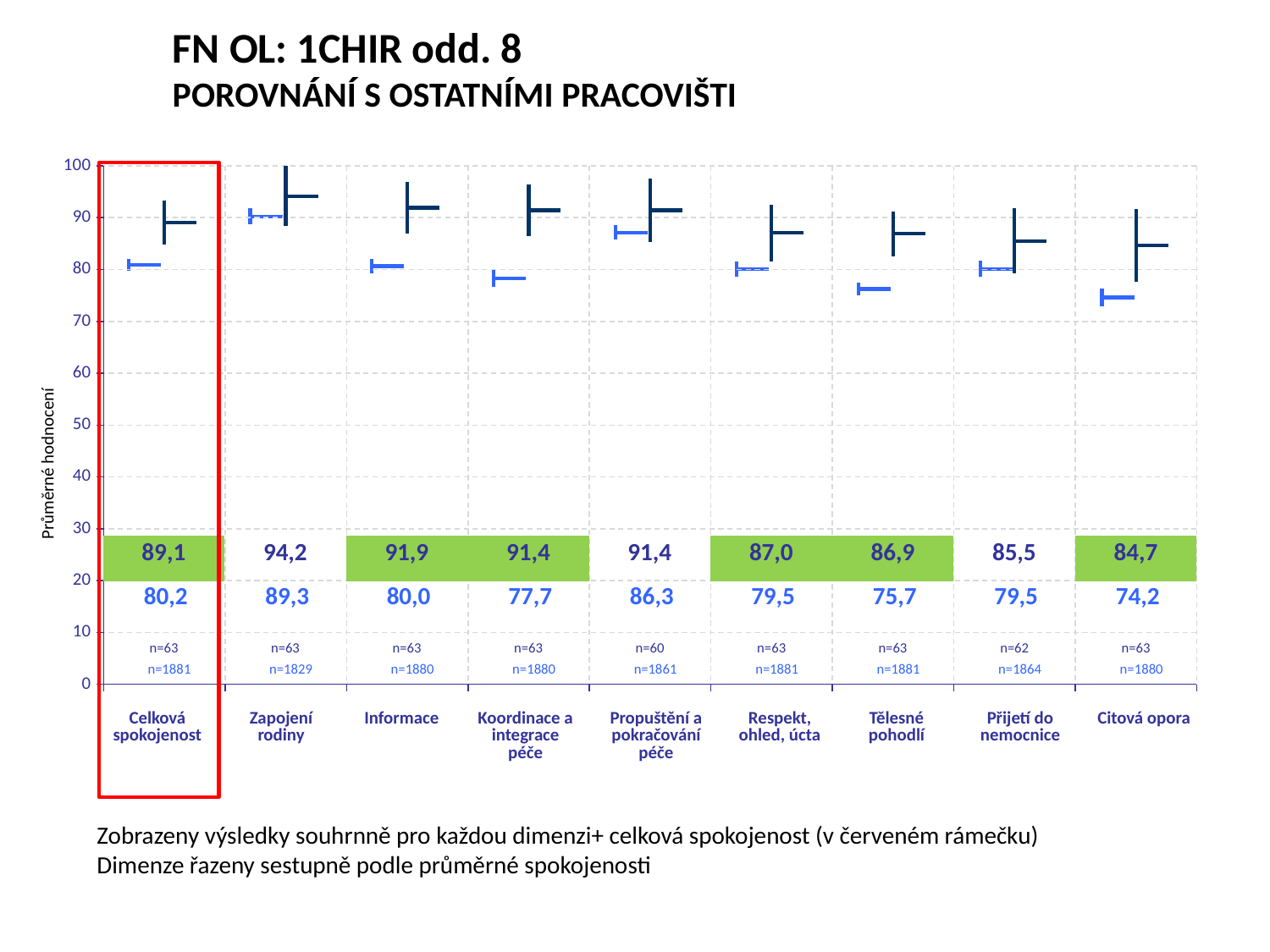
How many categories are shown along the x axis? 9 What is the label on the y axis? Průměrné hodnocení What is the difference between the upper value (89,1) and the lower value (80,2) for Celková spokojenost? 8,9 What is the lower (light blue) value printed for Citová opora? 74,2 What is the first n value printed for Propuštění a pokračování péče? n=60 Which has the larger upper (dark) value: Informace or Koordinace a integrace péče? Informace Which category has the highest upper (dark) value? Zapojení rodiny Which category is enclosed in the red frame? Celková spokojenost Is the light blue marker for Tělesné pohodlí greater or less than 80? less What is the difference between the upper value (94,2) and the lower value (89,3) for Zapojení rodiny? 4,9 What is the upper (dark) value printed for Zapojení rodiny? 94,2 Which category has the lowest lower (light blue) value? Citová opora